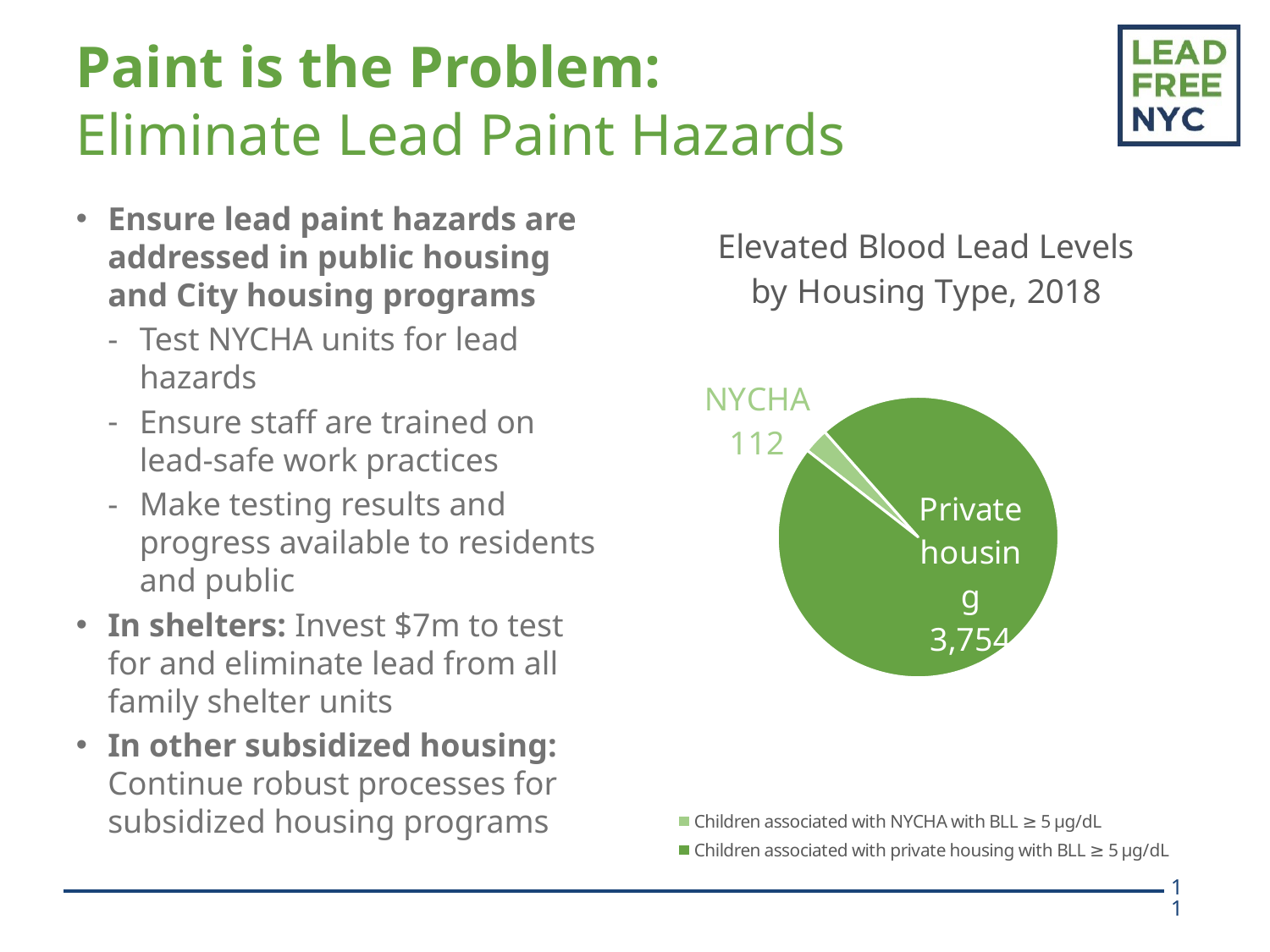
Which housing type has the smallest slice of the pie? NYCHA How many entries does the chart's legend list? 2 How many slices does the pie chart have? 2 Which is larger, the value for NYCHA or the value for Private housing? Private housing What is the title of the chart? Elevated Blood Lead Levels by Housing Type, 2018 What is the difference between the Private housing value and the NYCHA value? 3,642 Which housing type has the largest slice of the pie? Private housing What kind of chart is shown on the slide? Pie chart What is the value shown for Private housing in the pie chart? 3,754 What is the value shown for NYCHA in the pie chart? 112 What is the total of the two values shown in the pie chart? 3,866